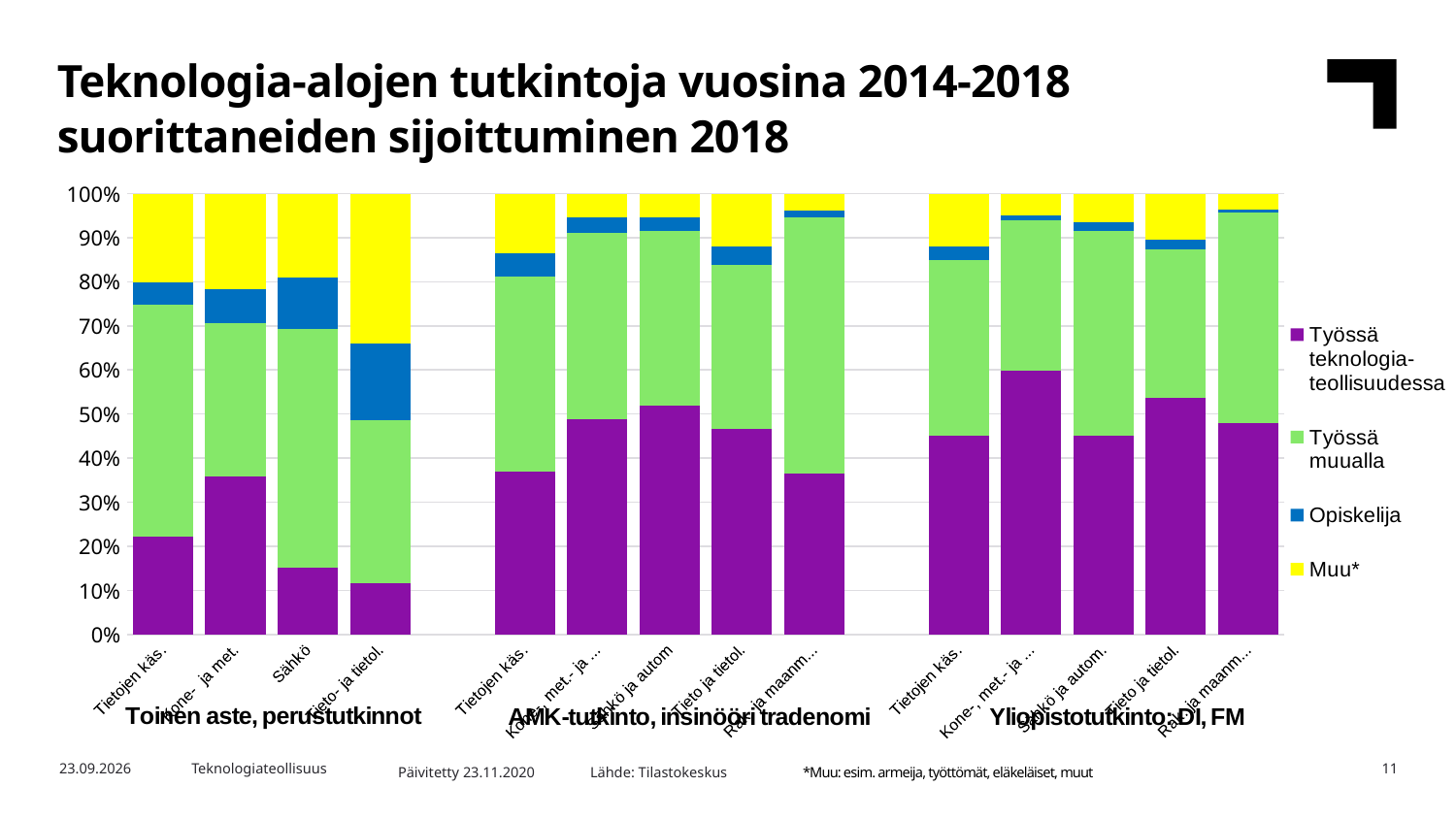
Which group contains the bar with the largest 'Muu*' share? Toinen aste, perustutkinnot How many bars are plotted in the chart in total? 14 How many bars are in the 'Toinen aste, perustutkinnot' group? 4 What kind of chart is shown on the slide? Stacked bar chart Within the 'Toinen aste, perustutkinnot' group, which bar has the largest 'Työssä teknologiateollisuudessa' share? Kone- ja met. Which series is shown in yellow in the legend? Muu* Is the 'Työssä teknologiateollisuudessa' share for 'Kone-, met- ja ...' in the 'Yliopistotutkinto; DI, FM' group greater or less than 50%? greater Is the 'Työssä teknologiateollisuudessa' share for 'Tietojen käs.' in the 'AMK-tutkinto, insinööri tradenomi' group greater or less than 40%? less Within the 'Yliopistotutkinto; DI, FM' group, which bar has the largest 'Työssä teknologiateollisuudessa' share? Kone-, met- ja ... Is the 'Työssä teknologiateollisuudessa' share for 'Sähkö' in the 'Toinen aste, perustutkinnot' group greater or less than 20%? less How many bars are in the 'Yliopistotutkinto; DI, FM' group? 5 How many series does the legend list? 4